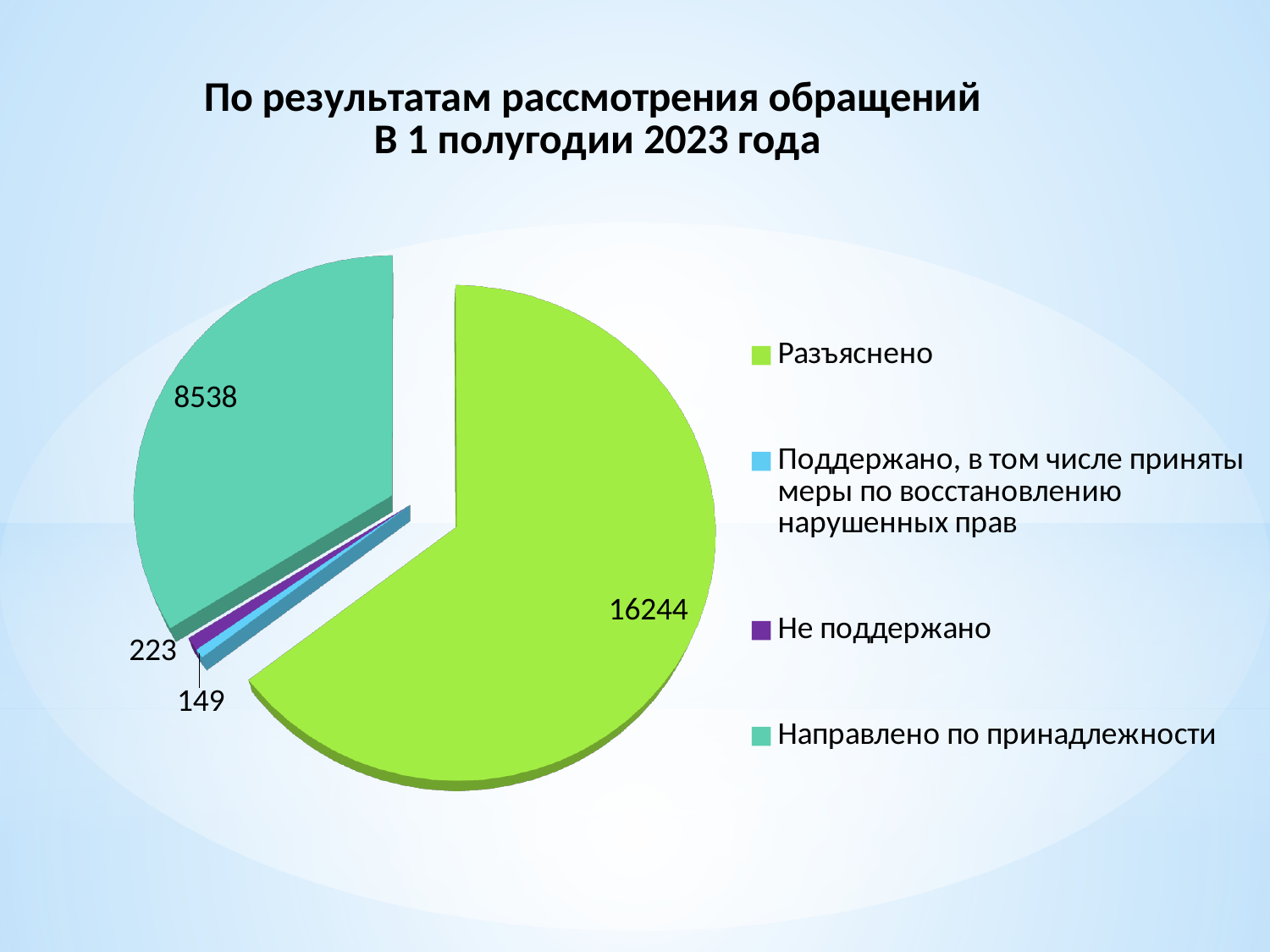
Which category has the largest slice of the pie? Разъяснено What is the value for Поддержано, в том числе приняты меры по восстановлению нарушенных прав? 149 Which category has the smallest slice of the pie? Поддержано, в том числе приняты меры по восстановлению нарушенных прав What type of chart is shown on the slide? Pie chart What is the value for Направлено по принадлежности? 8538 How many categories does the pie chart have? 4 What colour is the slice for Направлено по принадлежности? Teal What is the difference between the values for Разъяснено and Направлено по принадлежности? 7706 What is the value for Разъяснено? 16244 Which is larger, the value for Не поддержано or the value for Поддержано? Не поддержано What is the value for Не поддержано? 223 What is the difference between the values for Не поддержано and Поддержано? 74